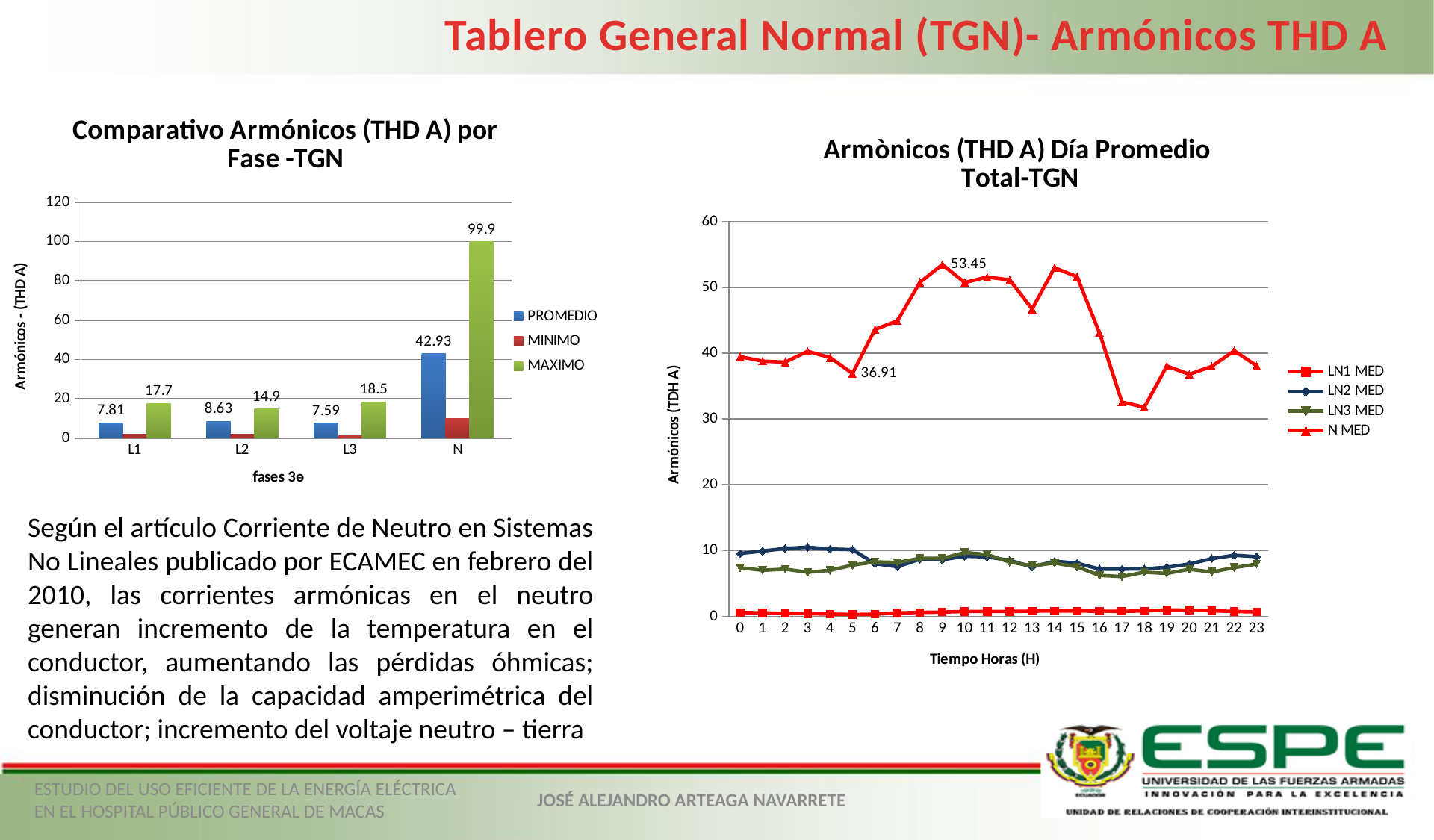
In the chart titled "Armònicos (THD A) Día Promedio Total-TGN", what is the highest labelled value of the N MED series? 53.45 In the chart titled "Armònicos (THD A) Día Promedio Total-TGN", is the N MED value at hour 17 greater or less than 40? less In the chart titled "Comparativo Armónicos (THD A) por Fase -TGN", which phase has the highest MAXIMO value? N In the chart titled "Armònicos (THD A) Día Promedio Total-TGN", how many series does the legend list? 4 In the chart titled "Comparativo Armónicos (THD A) por Fase -TGN", what is the PROMEDIO value for N? 42.93 In the chart titled "Comparativo Armónicos (THD A) por Fase -TGN", is the PROMEDIO value for L1 or L2 larger? L2 In the chart titled "Armònicos (THD A) Día Promedio Total-TGN", what value is labelled on the N MED series at hour 5? 36.91 In the chart titled "Comparativo Armónicos (THD A) por Fase -TGN", what is the difference between the MAXIMO values for L1 and L2? 2.8 In the chart titled "Comparativo Armónicos (THD A) por Fase -TGN", which phase has the lowest PROMEDIO value? L3 In the chart titled "Comparativo Armónicos (THD A) por Fase -TGN", what is the MAXIMO value for L3? 18.5 What kind of chart is the chart titled "Comparativo Armónicos (THD A) por Fase -TGN"? Bar chart In the chart titled "Comparativo Armónicos (THD A) por Fase -TGN", how many series does the legend list? 3